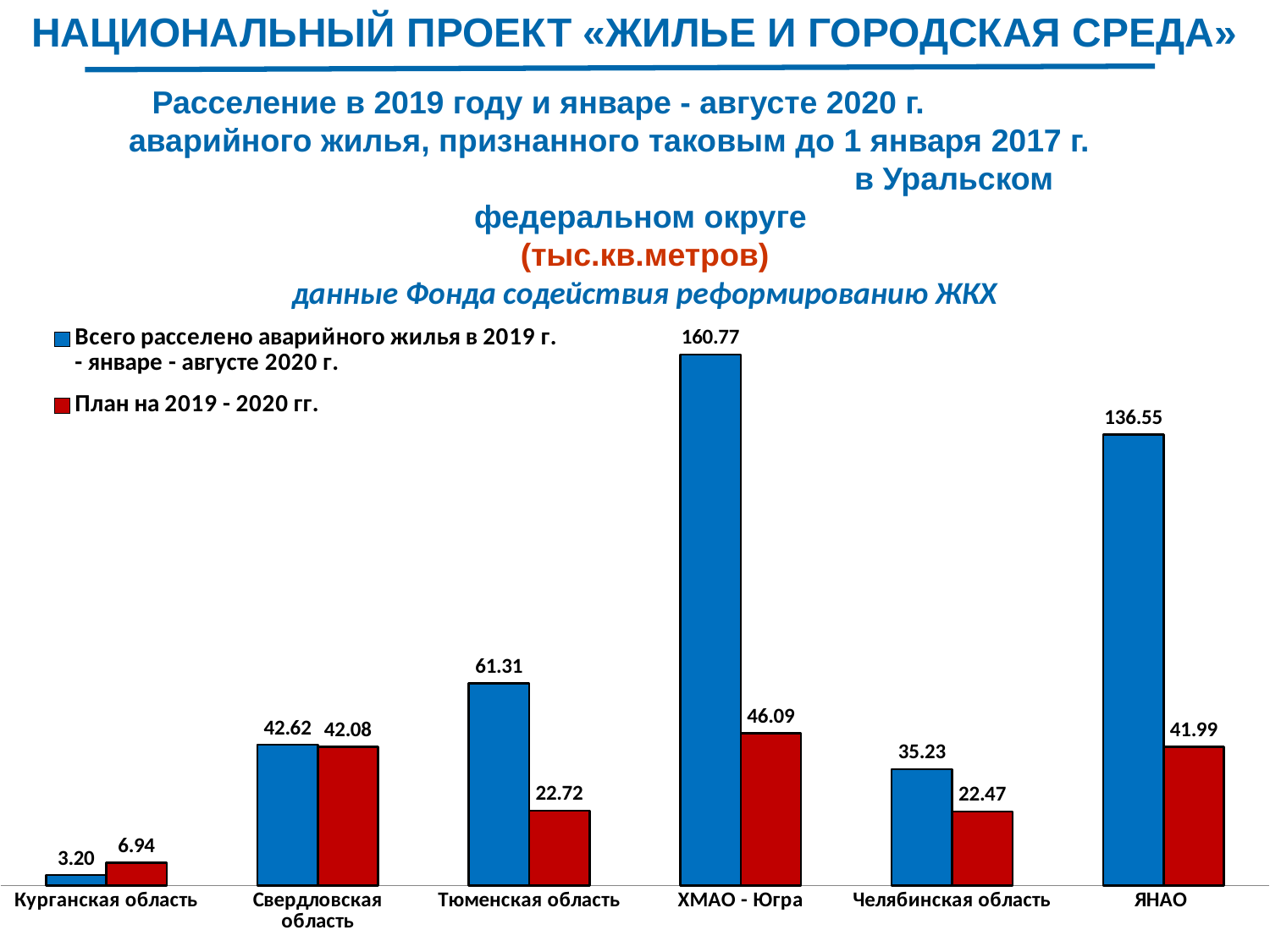
For Курганская область, which is larger: the blue value or the red value? The red value (6.94) What is the value of the blue series (Всего расселено аварийного жилья в 2019 г. - январе - августе 2020 г.) for ХМАО - Югра? 160.77 Which region has the highest value in the blue series (Всего расселено аварийного жилья)? ХМАО - Югра What is the difference between the blue and red values for ХМАО - Югра? 114.68 How many regions are shown on the x axis of the chart? 6 How many series does the legend list? 2 Which region has the lowest value in the red series (План на 2019 - 2020 гг.)? Курганская область What is the value of the red series (План на 2019 - 2020 гг.) for ЯНАО? 41.99 What is the value of the blue series for Курганская область? 3.20 What is the difference between the blue values for ХМАО - Югра and ЯНАО? 24.22 What kind of chart is shown on the slide? Bar chart What is the value of the red series (План на 2019 - 2020 гг.) for Тюменская область? 22.72